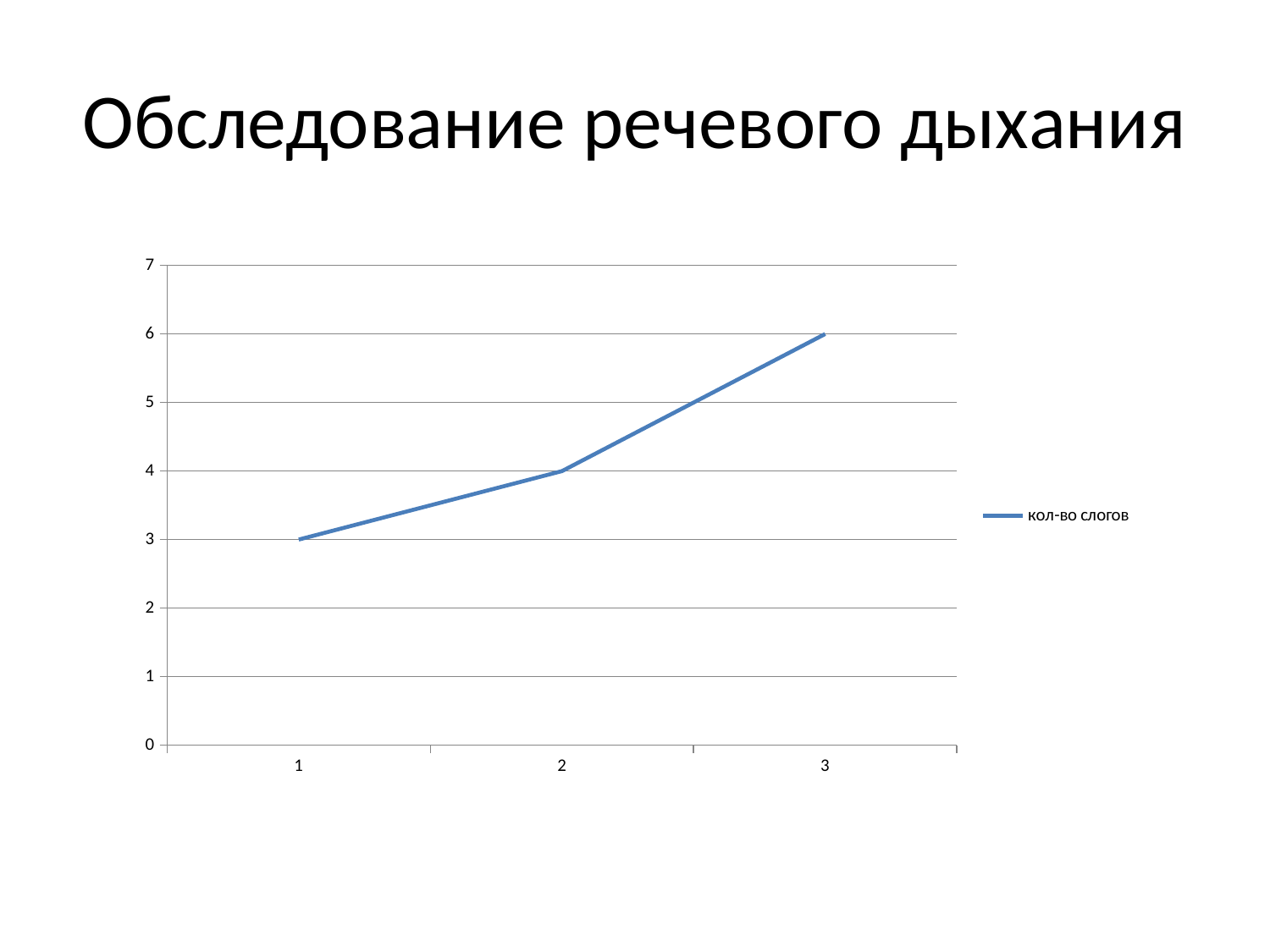
What is the value of кол-во слогов at point 3? 6 At which point on the x axis is кол-во слогов highest? 3 How many points are plotted on the line? 3 At which point on the x axis is кол-во слогов lowest? 1 Is the value at point 3 greater or less than 5? greater What is the value of кол-во слогов at point 1? 3 What kind of chart is shown on the slide? line chart Which is larger, the value at point 2 or the value at point 3? point 3 What is the difference between the value at point 3 and the value at point 1? 3 What is the value of кол-во слогов at point 2? 4 What series name does the legend show? кол-во слогов Do the values rise or fall from point 1 to point 3? rise